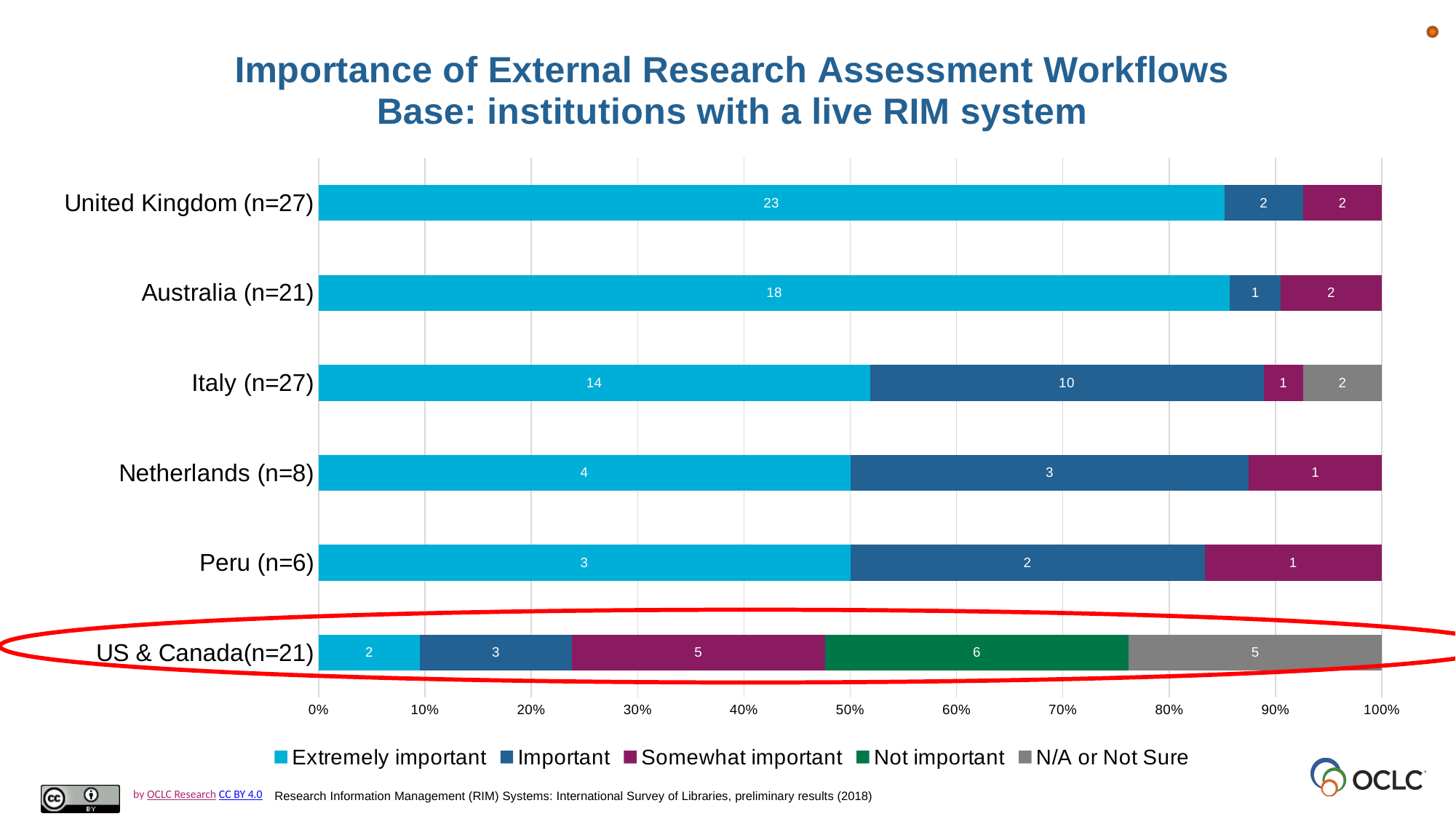
Which has a larger Important count, Italy (n=27) or Netherlands (n=8)? Italy (n=27) How many series does the legend list? 5 What is the total of the data labels in the US & Canada(n=21) bar? 21 Is the Extremely important share of the United Kingdom (n=27) bar greater or less than 80%? greater What kind of chart is shown on the slide? Stacked bar chart How many US & Canada (n=21) institutions answered Not important? 6 Which category has the lowest Extremely important count? US & Canada(n=21) Which category has the highest Extremely important count? United Kingdom (n=27) What is the difference between the Extremely important counts for United Kingdom (n=27) and Australia (n=21)? 5 How many institutions in the United Kingdom (n=27) rated external research assessment workflows as Extremely important? 23 What is the Important count for Italy (n=27)? 10 How many categories (regions) are shown on the chart? 6